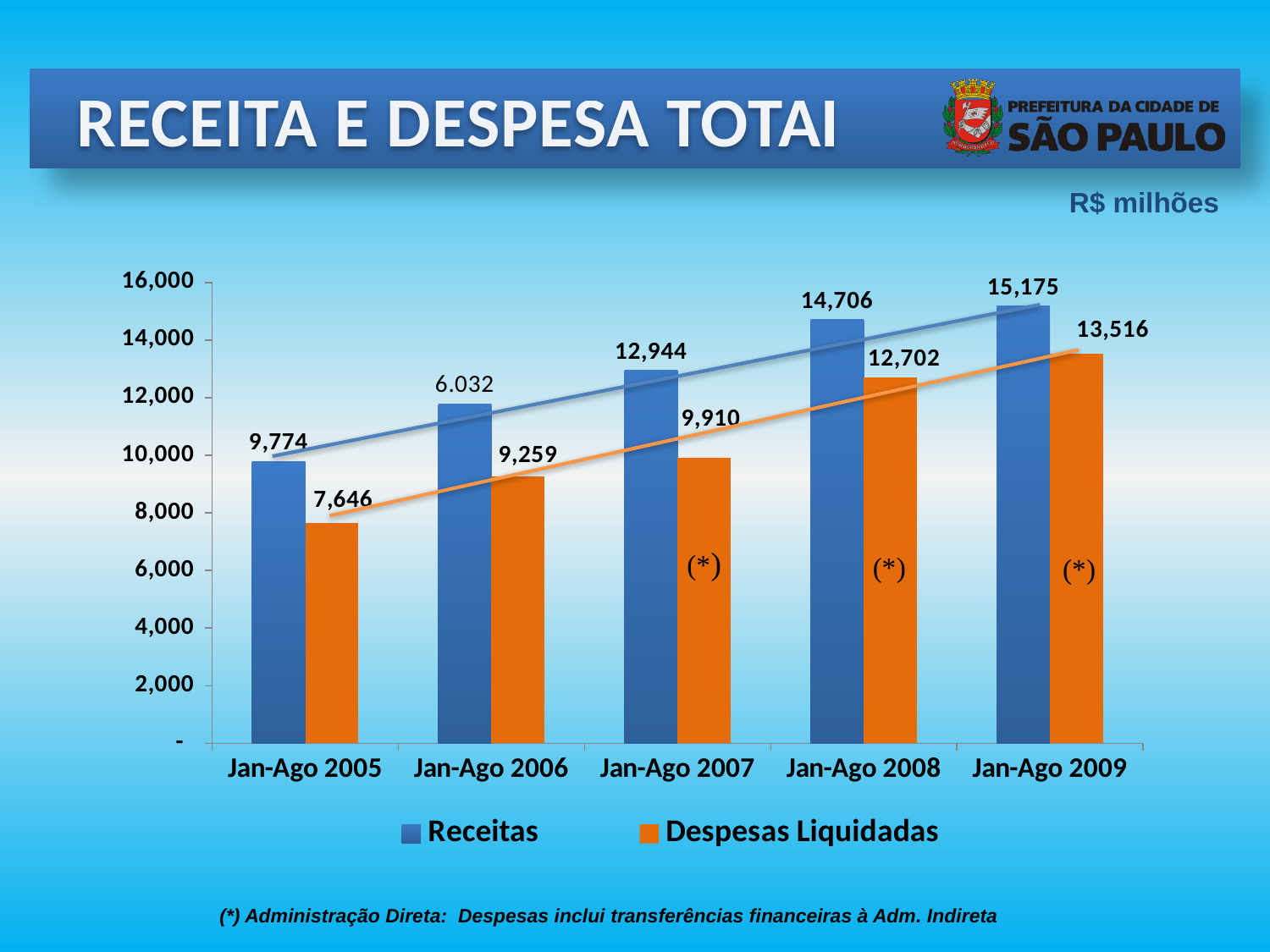
What is the difference between Receitas and Despesas Liquidadas in Jan-Ago 2009? 1,659 How many periods are shown on the x axis? 5 What kind of chart is shown on the slide? Bar chart In which period is Despesas Liquidadas lowest? Jan-Ago 2005 What is the difference between Receitas and Despesas Liquidadas in Jan-Ago 2008? 2,004 Which is larger: Receitas in Jan-Ago 2007 or Despesas Liquidadas in Jan-Ago 2008? Receitas in Jan-Ago 2007 In which period is Receitas highest? Jan-Ago 2009 How many series does the legend list? 2 What is the value of Despesas Liquidadas for Jan-Ago 2007? 9,910 What is the value of Receitas for Jan-Ago 2005? 9,774 What is the value of Despesas Liquidadas for Jan-Ago 2009? 13,516 Do the Despesas Liquidadas values rise or fall from Jan-Ago 2005 to Jan-Ago 2009? Rise